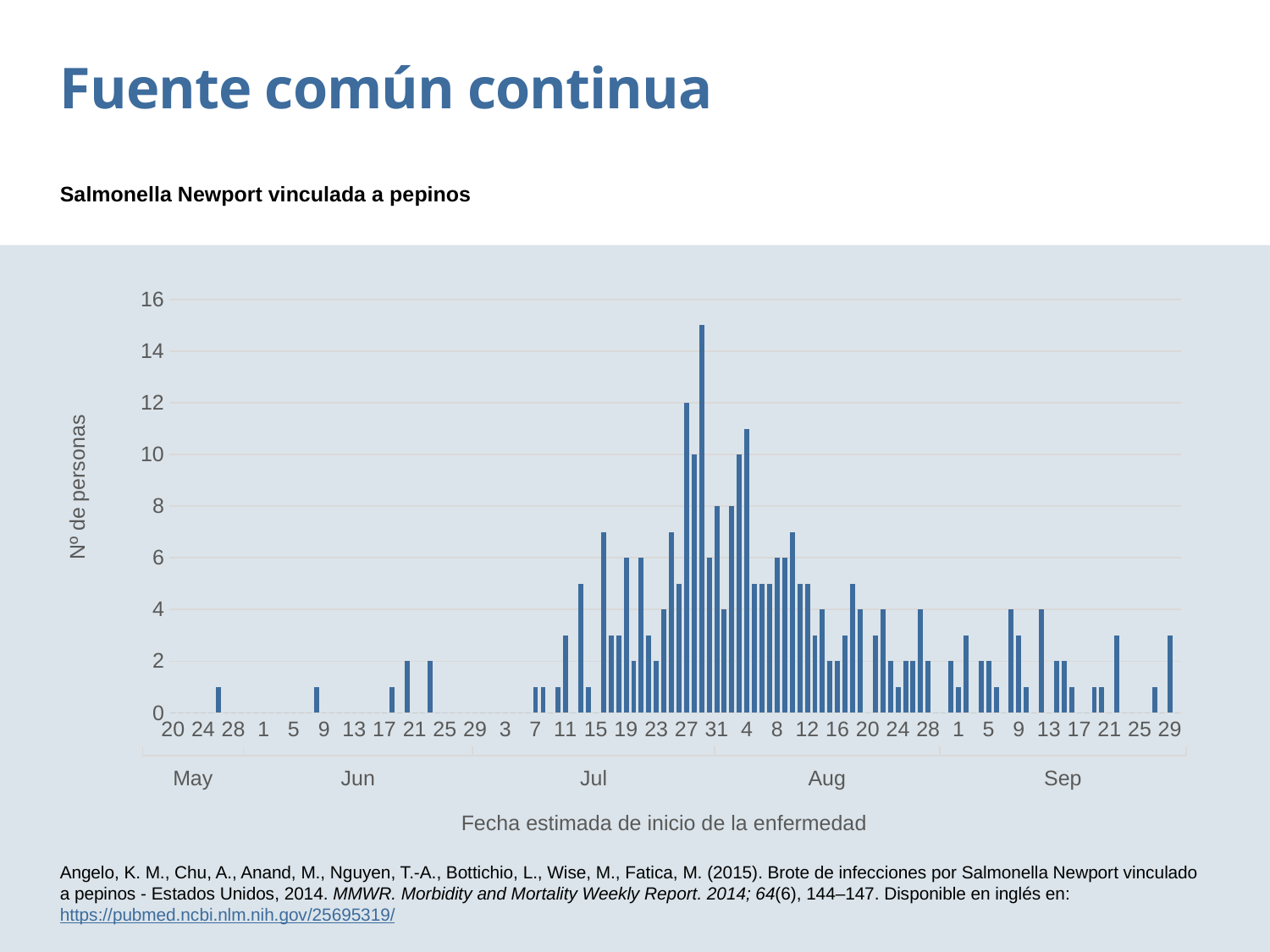
How many months are labelled along the x axis of the chart? 5 In which month does the tallest bar of the chart occur? Jul Is the value of the tallest bar in the chart greater or less than 14? greater From late July to the end of September, do the bar heights generally rise or fall? fall Is the highest bar in September greater or less than 6? less What kind of chart is shown on the slide? bar chart Is the value of the tallest bar in the chart greater or less than 16? less Which month has the fewest bars in the chart? May What is the label of the y axis of the chart? Nº de personas Which month has the taller peak bar, July or September? Jul